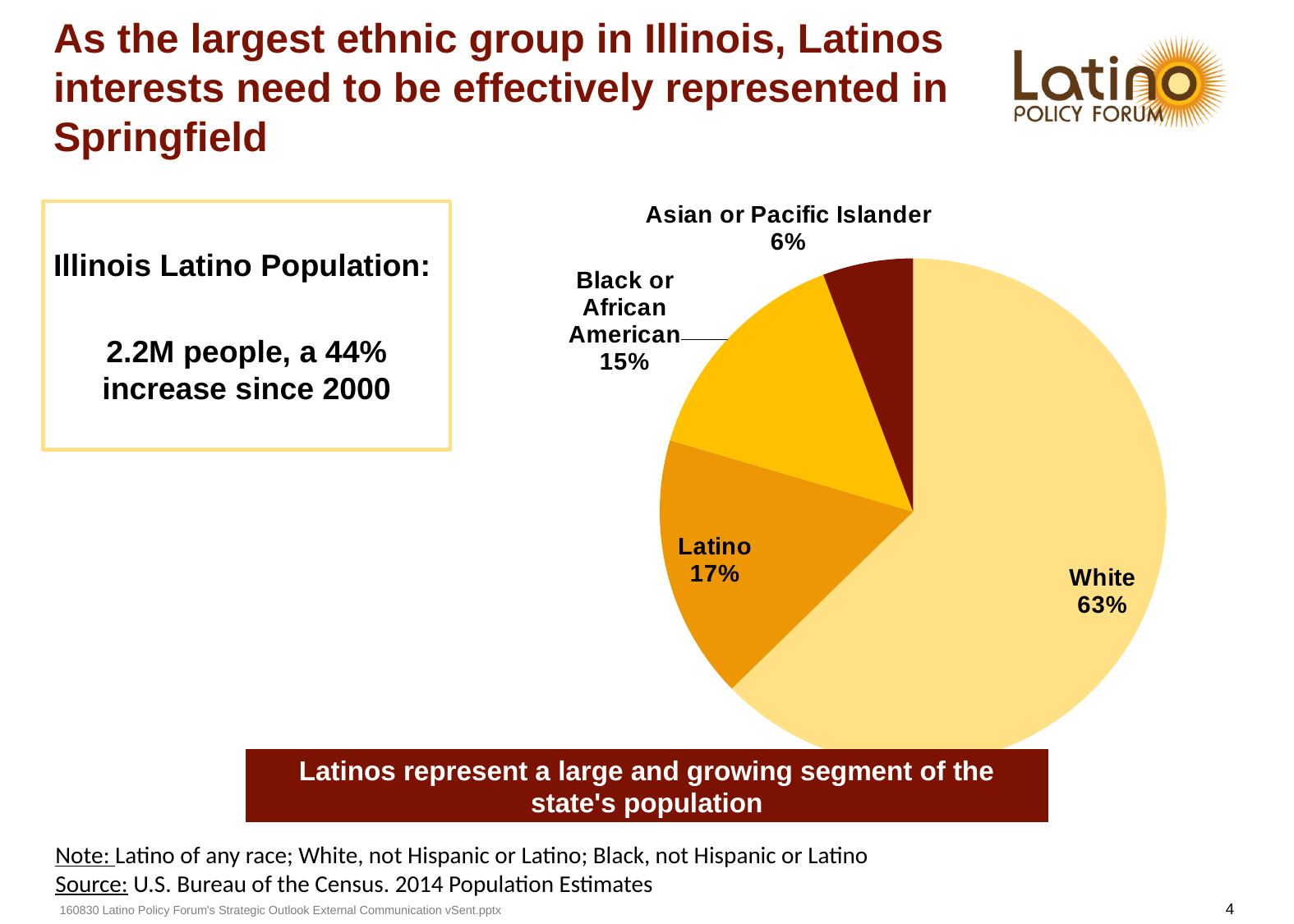
What type of chart is shown on the slide? pie chart How many slices does the pie chart have? 4 What is the difference in percentage points between the Latino slice and the Black or African American slice? 2 Which group has the largest slice of the pie? White What percentage is shown for Black or African American? 15% What colour is the White slice of the pie? light yellow What share of the pie does the White slice represent? 63% What percentage is shown for Asian or Pacific Islander? 6% What percentage is shown for Latino? 17% What is the difference in percentage points between the White slice and the Latino slice? 46 Which group has the smallest slice of the pie? Asian or Pacific Islander Which is larger, the Latino slice or the Asian or Pacific Islander slice? Latino